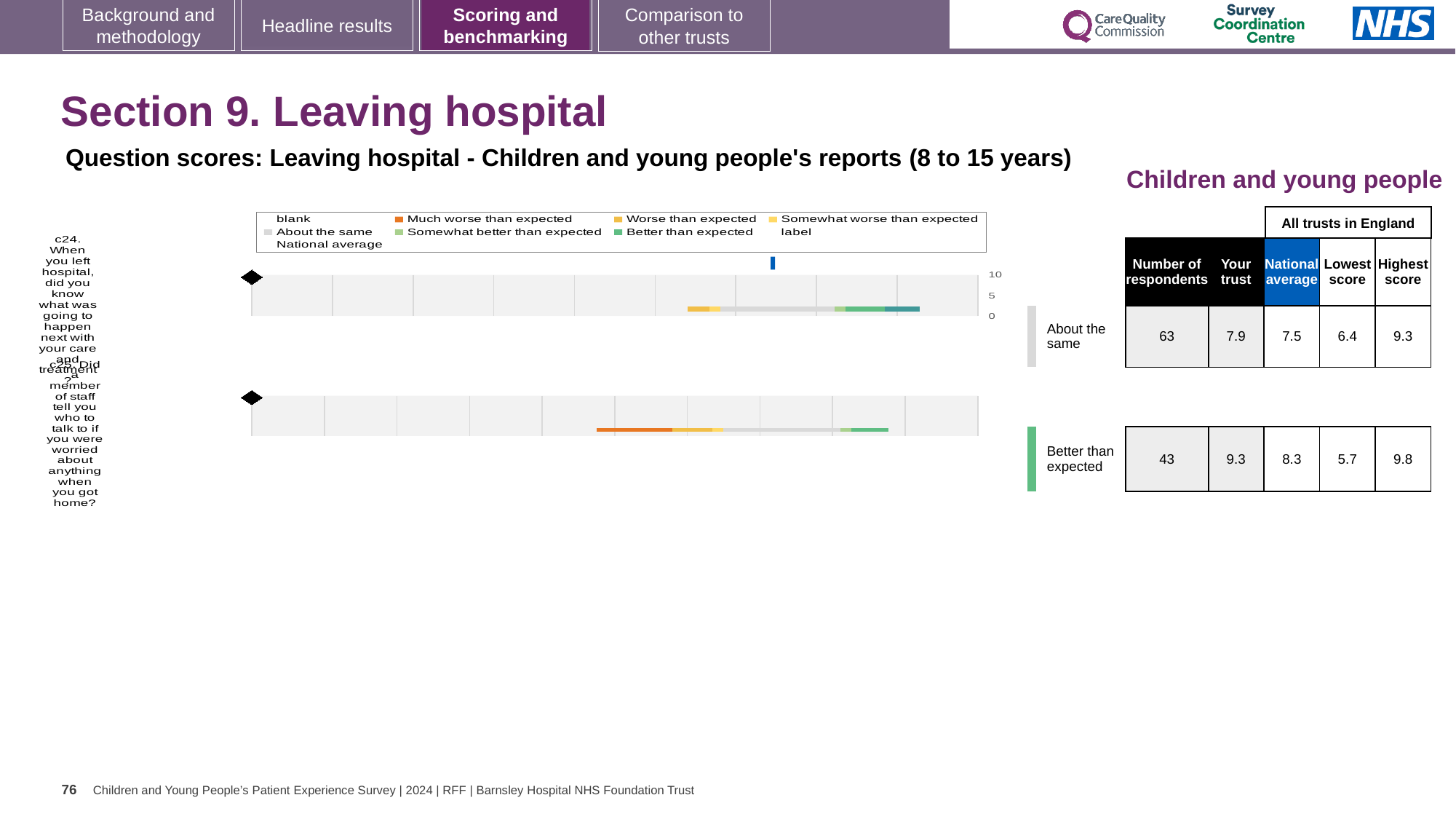
What is the highest tick value shown on the chart's score axis? 10 What is the difference between the 'Your trust' scores for c25 (9.3) and c24 (7.9)? 1.4 How many survey questions (rows) are plotted in the Leaving hospital chart? 2 In the table beside the chart, what is the lowest score in England for the first question (c24)? 6.4 In the table beside the chart, what is the highest score in England for the second question (c25)? 9.8 In the table beside the chart, what is the national average for the first question (c24)? 7.5 In the table beside the chart, how many respondents answered the second question (c25)? 43 What kind of chart is used to show the question scores for Leaving hospital? bar chart In the chart legend, what colour represents 'Much worse than expected'? orange Which question has the higher 'Your trust' score, c24 or c25? c25 In the table beside the chart, what is the 'Your trust' score for the first question (c24, knowing what was going to happen next)? 7.9 In the table beside the chart, what is the 'Your trust' score for the second question (c25, told who to talk to if worried)? 9.3